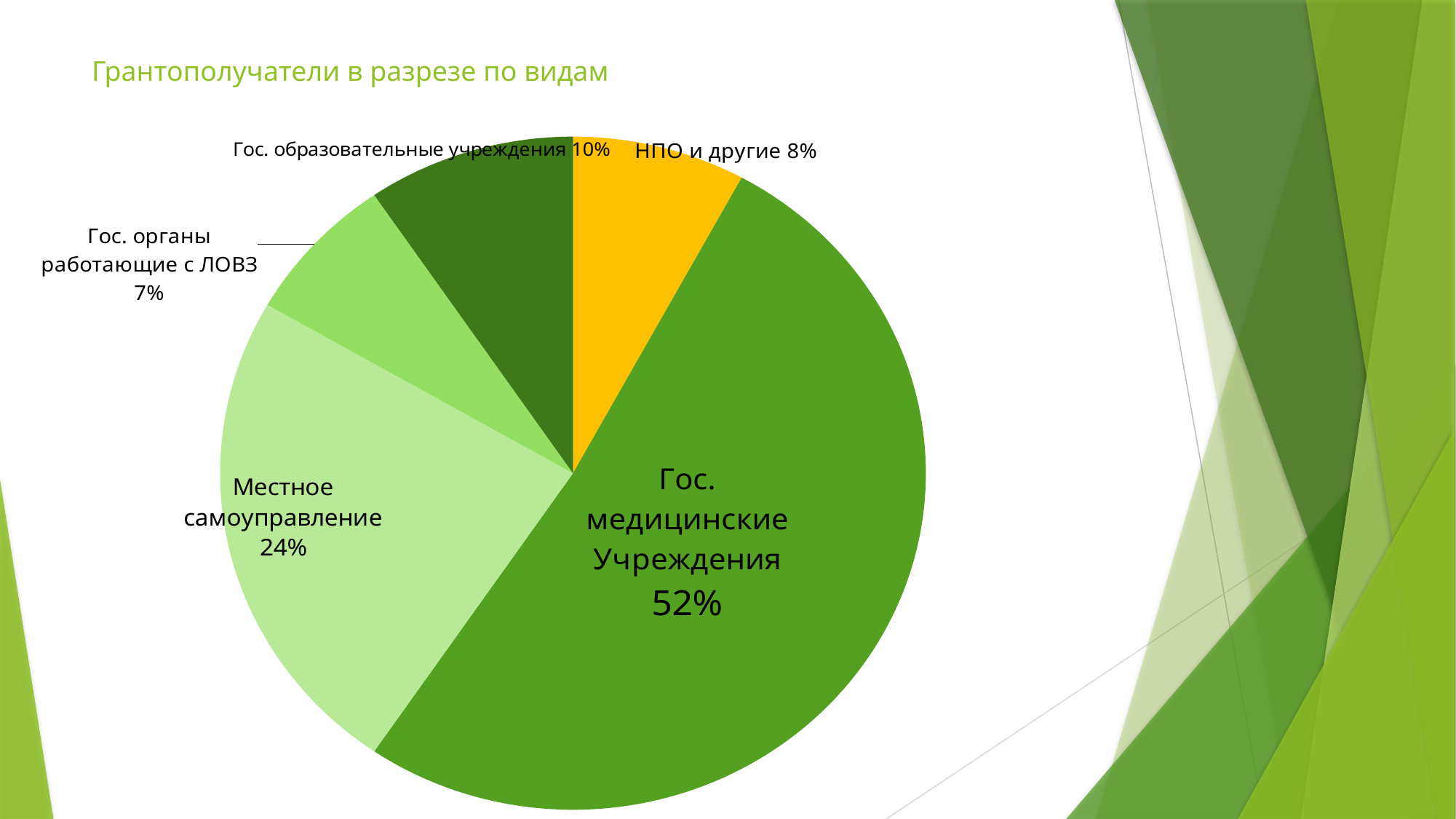
What share of the pie does Гос. медицинские Учреждения hold? 52% What is the difference in percentage points between Гос. медицинские Учреждения and Местное самоуправление? 28 How many categories are shown in the pie chart? 5 Which category has the largest slice of the pie? Гос. медицинские Учреждения What is the value shown for Гос. органы работающие с ЛОВЗ? 7% What share of the pie does Местное самоуправление hold? 24% Which category has the smallest slice of the pie? Гос. органы работающие с ЛОВЗ What is the value shown for НПО и другие? 8% What is the title of the chart on the slide? Грантополучатели в разрезе по видам Which is larger: Гос. образовательные учреждения or НПО и другие? Гос. образовательные учреждения What kind of chart is shown on the slide? Pie chart What is the value shown for Гос. образовательные учреждения? 10%